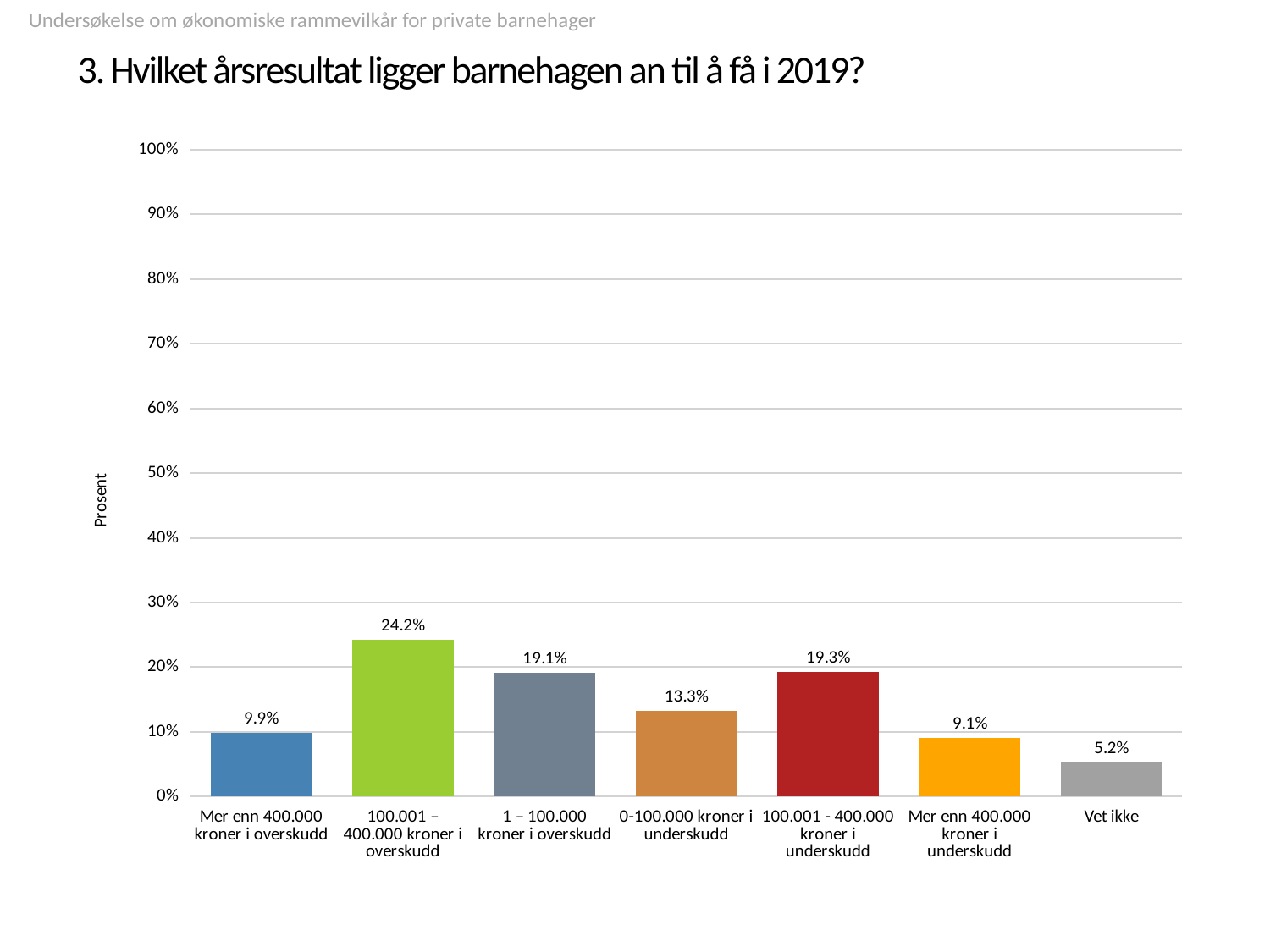
What is the difference between the values for 'Mer enn 400.000 kroner i overskudd' and 'Vet ikke'? 4.7 percentage points Is the value for '0-100.000 kroner i underskudd' greater or less than 10%? greater What is the value shown for 'Vet ikke'? 5.2% What percentage of respondents expect a result of 100.001 – 400.000 kroner i overskudd in 2019? 24.2% What kind of chart is shown on the slide? Bar chart What percentage is shown for '0-100.000 kroner i underskudd'? 13.3% What is the label of the vertical axis? Prosent What is the difference between the values for '100.001 – 400.000 kroner i overskudd' and '1 – 100.000 kroner i overskudd'? 5.1 percentage points Which category has the lowest value? Vet ikke How many categories are shown on the x axis? 7 Which category has the highest value? 100.001 – 400.000 kroner i overskudd Which is larger: the value for 'Mer enn 400.000 kroner i overskudd' or the value for 'Mer enn 400.000 kroner i underskudd'? Mer enn 400.000 kroner i overskudd